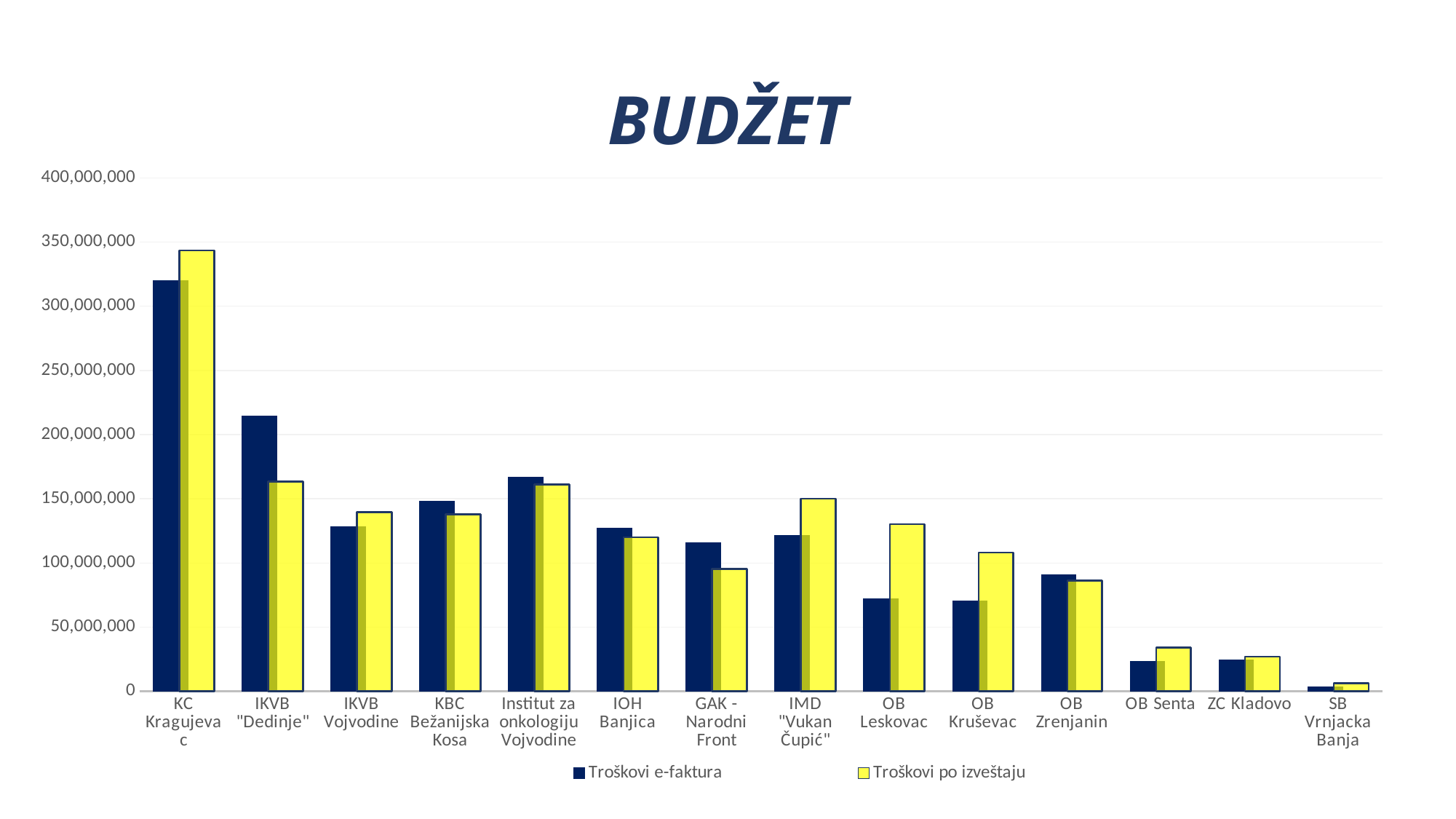
Is the Troškovi e-faktura value for OB Kruševac greater or less than 100,000,000? less What kind of chart is shown on the slide? bar chart For IKVB "Dedinje", which is larger: Troškovi e-faktura or Troškovi po izveštaju? Troškovi e-faktura Is the Troškovi e-faktura value for KC Kragujevac greater or less than 300,000,000? greater What is the title of the chart? BUDŽET How many institutions (categories) are shown on the x axis? 14 Is the Troškovi po izveštaju value for OB Senta greater or less than 50,000,000? less Which institution has the lowest value for Troškovi po izveštaju? SB Vrnjacka Banja Which institution has the highest value for Troškovi e-faktura? KC Kragujevac How many series does the legend list? 2 For OB Leskovac, which is larger: Troškovi e-faktura or Troškovi po izveštaju? Troškovi po izveštaju